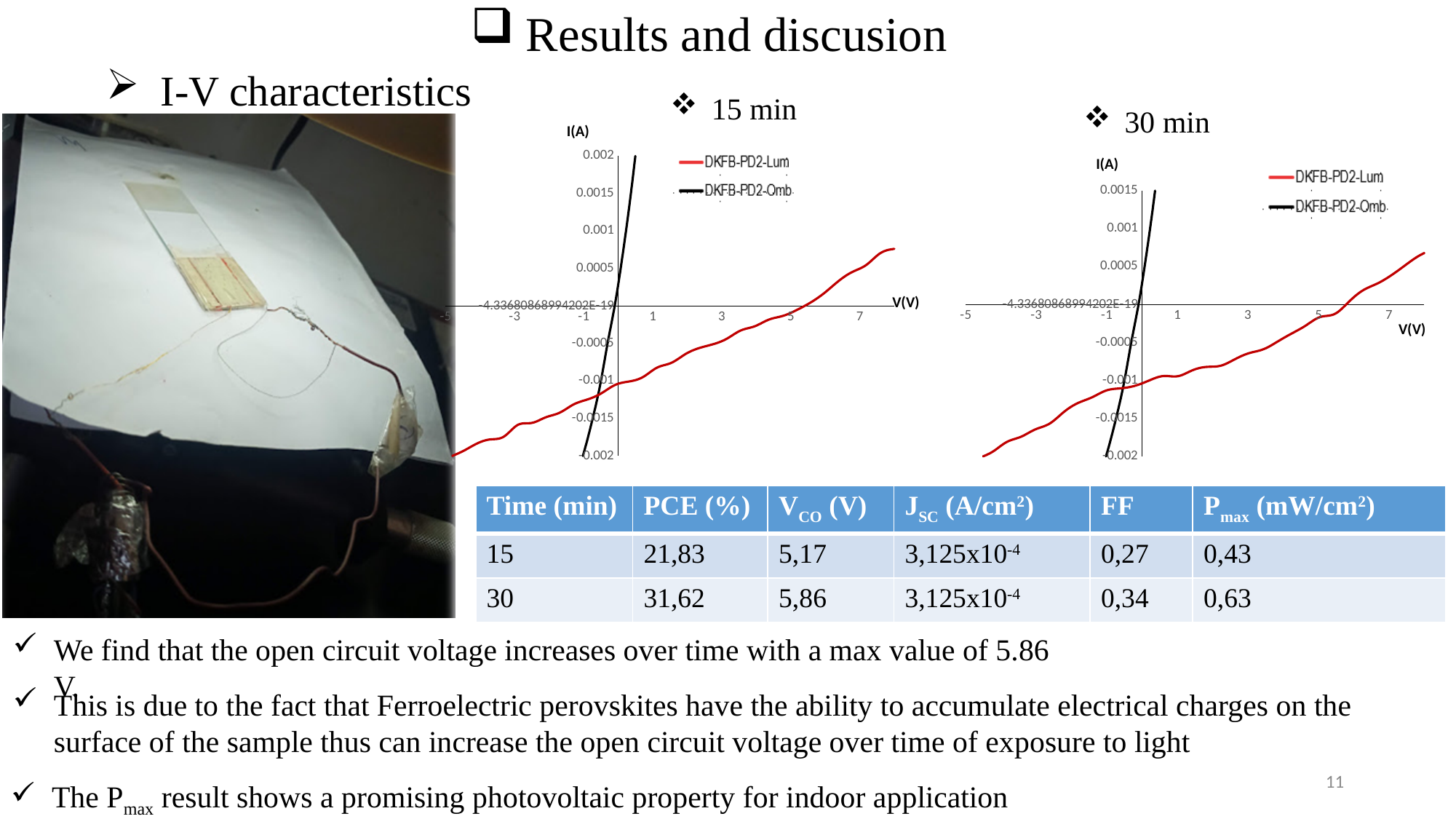
In the 15 min chart, does the DKFB-PD2-Lum current rise or fall as V(V) increases? rise In the 30 min chart, which series has the steeper slope, DKFB-PD2-Lum or DKFB-PD2-Omb? DKFB-PD2-Omb In the 15 min chart, is the DKFB-PD2-Lum value at V = 0 greater or less than 0? less In the 30 min chart, is the DKFB-PD2-Lum value at V = -3 greater or less than -0.001? less How many series does the legend of the 30 min chart list? 2 In the 15 min chart, which series has the steeper slope, DKFB-PD2-Lum or DKFB-PD2-Omb? DKFB-PD2-Omb In the 15 min chart, what colour is the DKFB-PD2-Lum series drawn in? red What kind of chart is the 15 min chart? line chart In the 30 min chart, does the DKFB-PD2-Lum current rise or fall as V(V) increases? rise What are the two series named in the legend of the 15 min chart? DKFB-PD2-Lum and DKFB-PD2-Omb